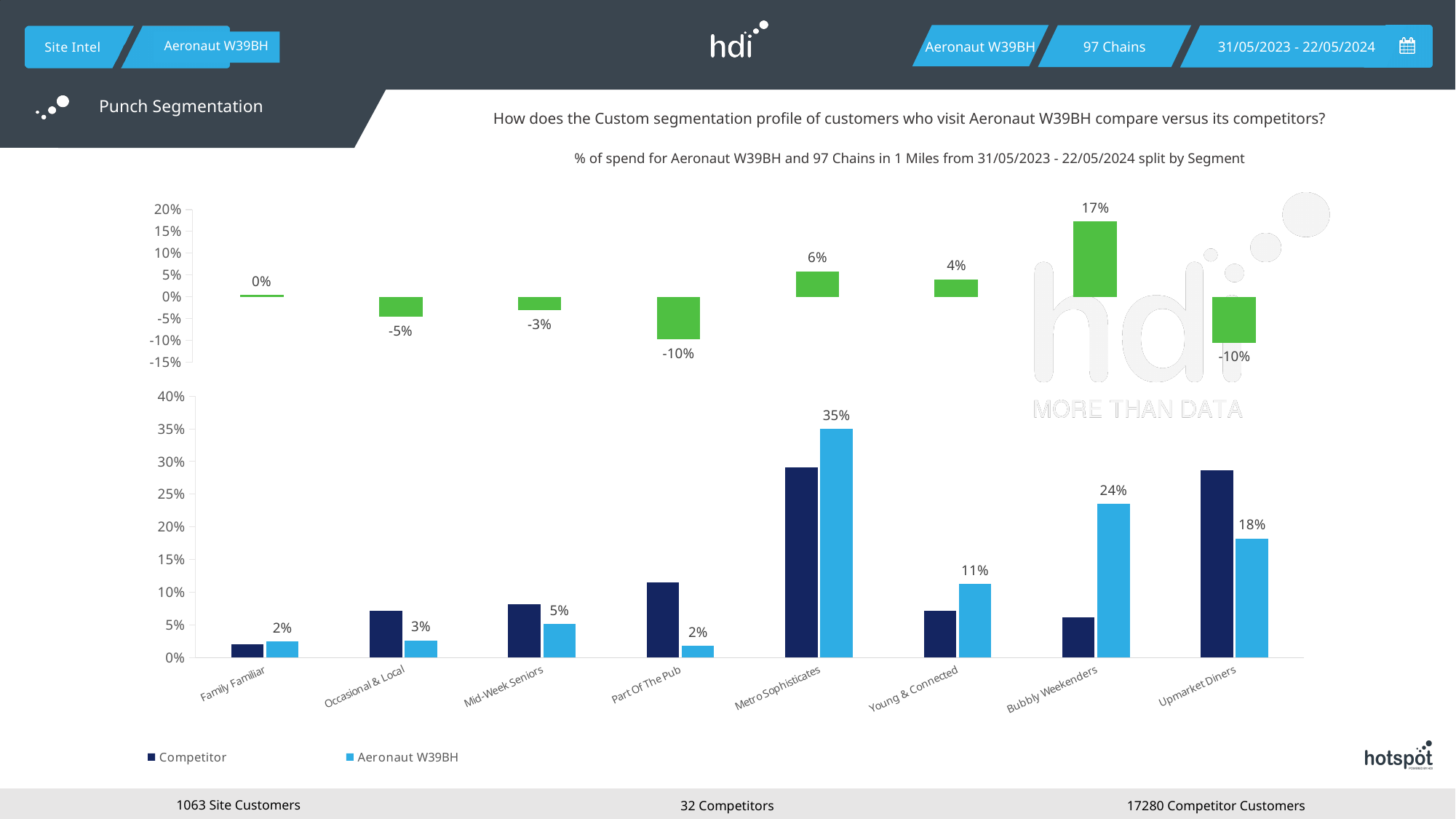
How many series does the legend of the bottom chart list? 2 In the bottom chart, what is the Aeronaut W39BH value for Metro Sophisticates? 35% In the bottom chart, which segment has the highest Aeronaut W39BH value? Metro Sophisticates In the top chart, what is the value shown for Bubbly Weekenders? 17% In the bottom chart, is the Competitor value for Bubbly Weekenders greater or less than 10%? less In the bottom chart, which is larger for Upmarket Diners, the Competitor bar or the Aeronaut W39BH bar? Competitor In the bottom chart, what is the Aeronaut W39BH value for Bubbly Weekenders? 24% How many segments are shown on the x axis of the bottom chart? 8 In the top chart, which segment has the highest value? Bubbly Weekenders In the bottom chart, what is the difference between the Aeronaut W39BH values for Metro Sophisticates and Upmarket Diners? 17% In the bottom chart, is the Competitor value for Upmarket Diners greater or less than 25%? greater In the top chart, what is the value shown for Part Of The Pub? -10%